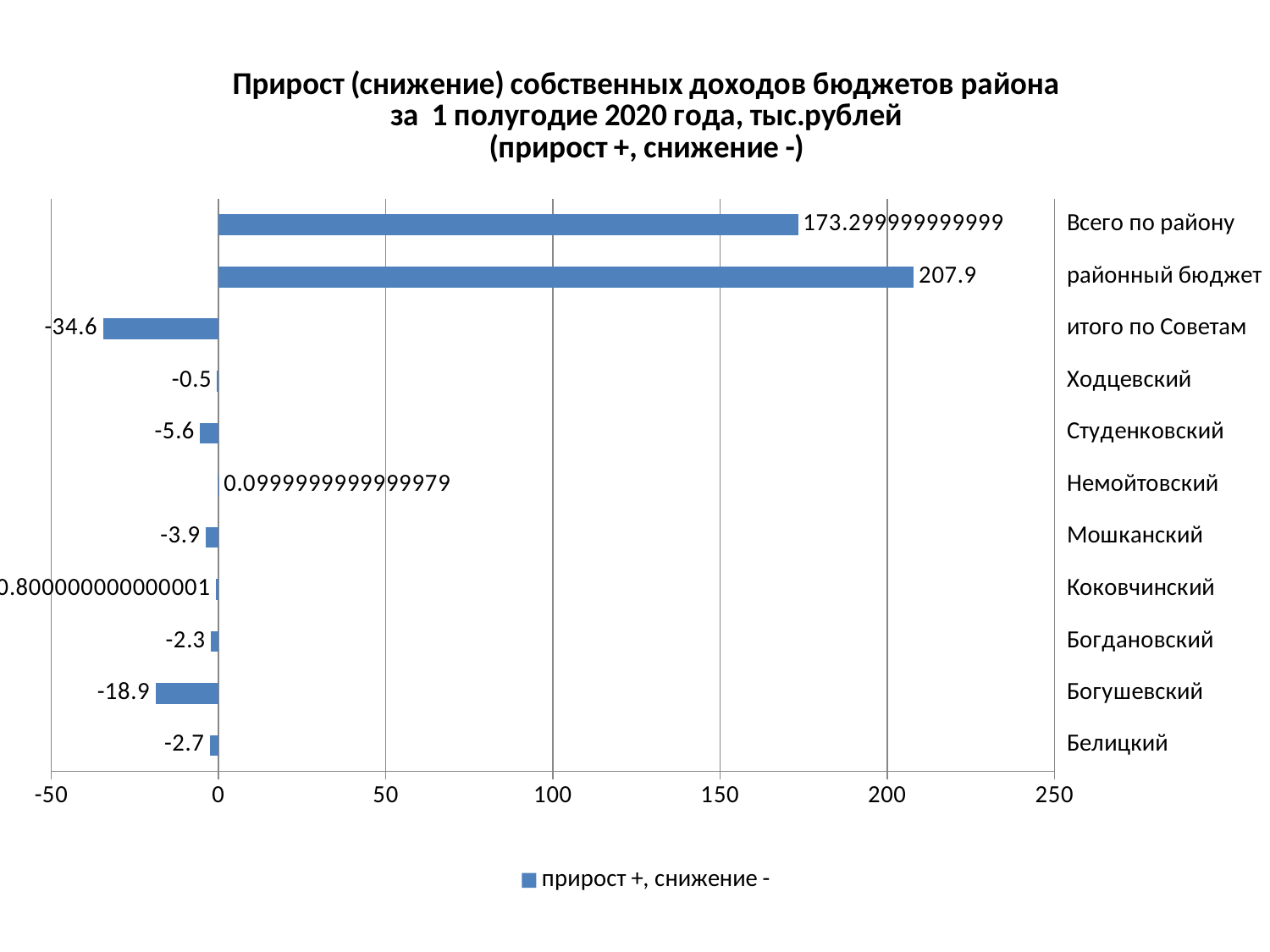
What kind of chart is shown on the slide? bar chart How many categories are shown on the chart? 11 Which category has the highest value? районный бюджет Is the value for Всего по району greater or less than 150? greater What is the value for итого по Советам? -34.6 What is the value for районный бюджет? 207.9 What is the value for Студенковский? -5.6 Which is larger, the value for Богушевский or the value for Богдановский? Богдановский What is the difference between the values for районный бюджет and итого по Советам? 242.5 What is the value for Богушевский? -18.9 Which category has the lowest value? итого по Советам What is the value for Белицкий? -2.7